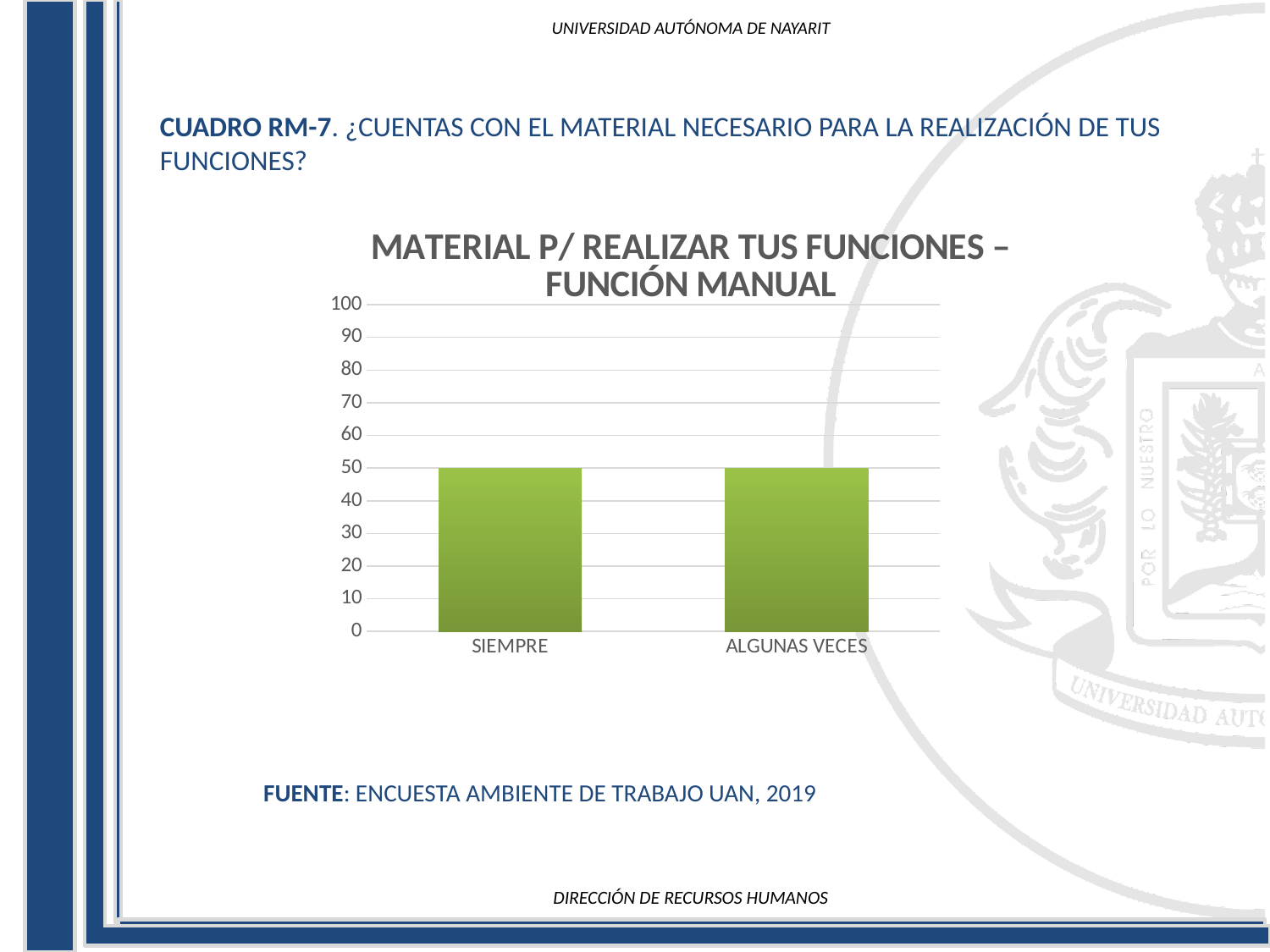
What is the highest value shown on the y axis? 100 What is the difference between the values for SIEMPRE and ALGUNAS VECES? 0 What is the title of the chart? MATERIAL P/ REALIZAR TUS FUNCIONES – FUNCIÓN MANUAL What is the value for ALGUNAS VECES? 50 Is the value for SIEMPRE greater or less than 60? less What is the value for SIEMPRE? 50 Is the value for ALGUNAS VECES greater or less than 40? greater How many categories are shown on the x axis of the chart? 2 What kind of chart is shown on the slide? Bar chart Which categories are labelled on the x axis of the chart? SIEMPRE and ALGUNAS VECES